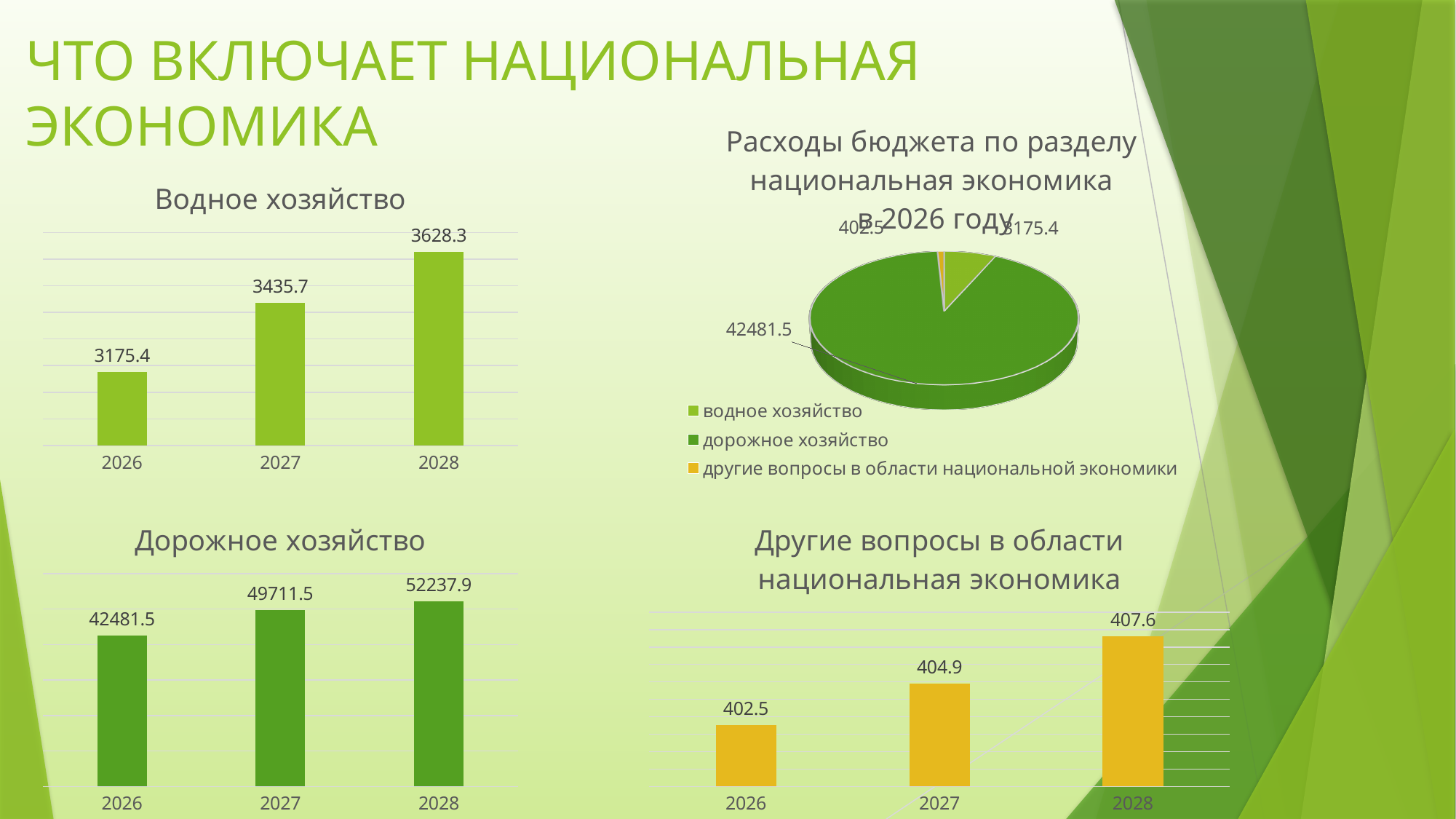
How many years are shown in the 'Другие вопросы в области национальная экономика' chart? 3 In the 'Водное хозяйство' chart, what is the value for 2027? 3435.7 In the 'Другие вопросы в области национальная экономика' chart, what is the difference between the 2028 and 2026 values? 5.1 What kind of chart is 'Расходы бюджета по разделу национальная экономика в 2026 году'? pie chart In the 'Дорожное хозяйство' chart, what is the value for 2028? 52237.9 In the 'Другие вопросы в области национальная экономика' chart, what is the value for 2027? 404.9 In the pie chart 'Расходы бюджета по разделу национальная экономика в 2026 году', what is the value for 'дорожное хозяйство'? 42481.5 How many entries does the legend of the pie chart 'Расходы бюджета по разделу национальная экономика в 2026 году' list? 3 In the 'Дорожное хозяйство' chart, do the values rise or fall from 2026 to 2028? rise In the 'Дорожное хозяйство' chart, which year has the lowest value? 2026 In the 'Водное хозяйство' chart, what is the difference between the 2028 and 2026 values? 452.9 In the 'Водное хозяйство' chart, which year has the highest value? 2028